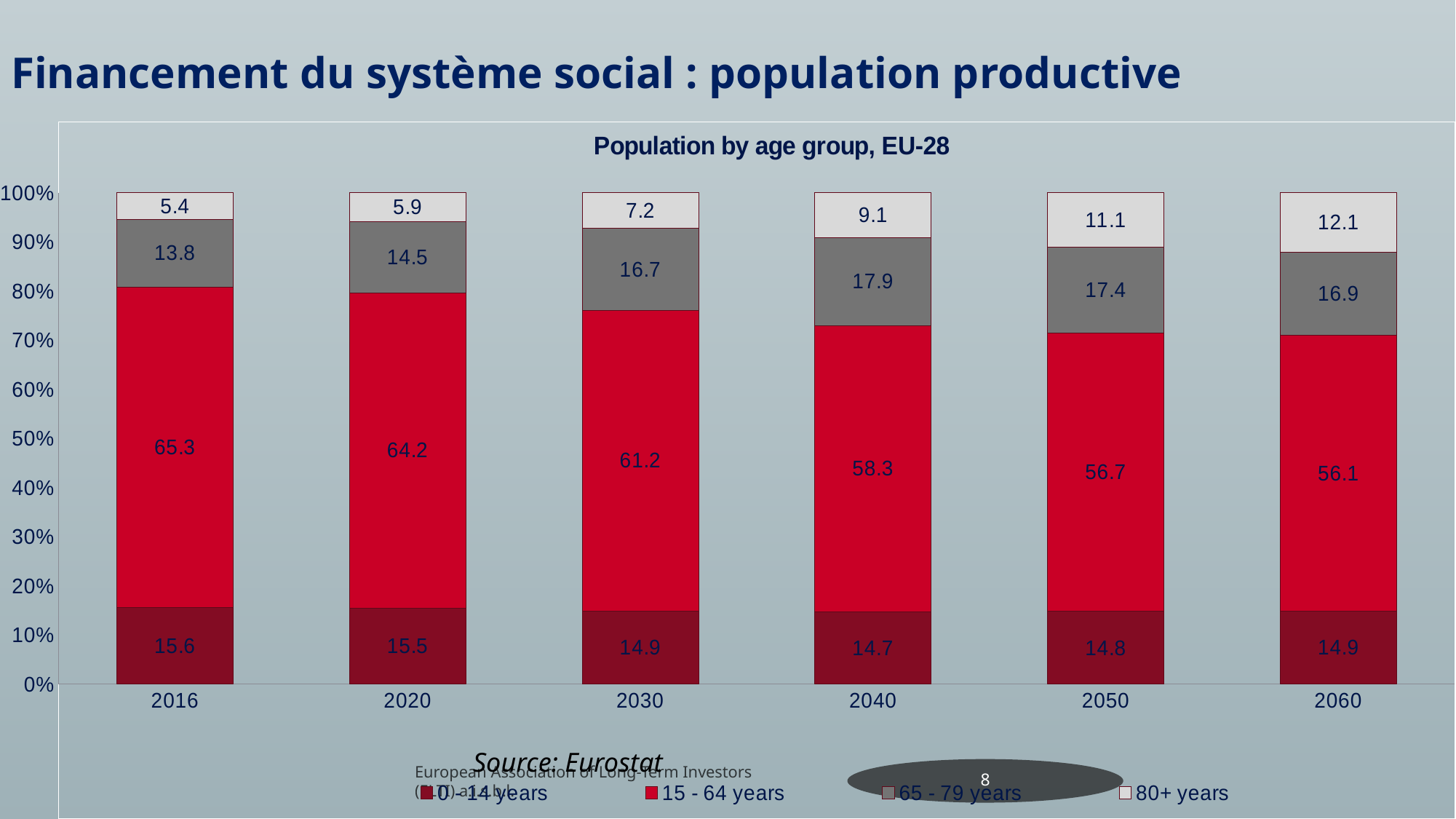
What kind of chart is shown? Stacked bar chart What is the value for the 65 - 79 years series in 2040? 17.9 Which is larger: the 65 - 79 years value in 2040 or in 2050? 2040 What is the title of the chart? Population by age group, EU-28 How many years are shown on the x axis? 6 Does the 80+ years value rise or fall from 2016 to 2060? Rise In which year is the 15 - 64 years value the lowest? 2060 What is the difference between the 15 - 64 years values in 2016 and 2060? 9.2 In which year is the 80+ years value the highest? 2060 What is the value for the 15 - 64 years series in 2016? 65.3 What is the value for the 80+ years series in 2060? 12.1 How many series does the legend list? 4